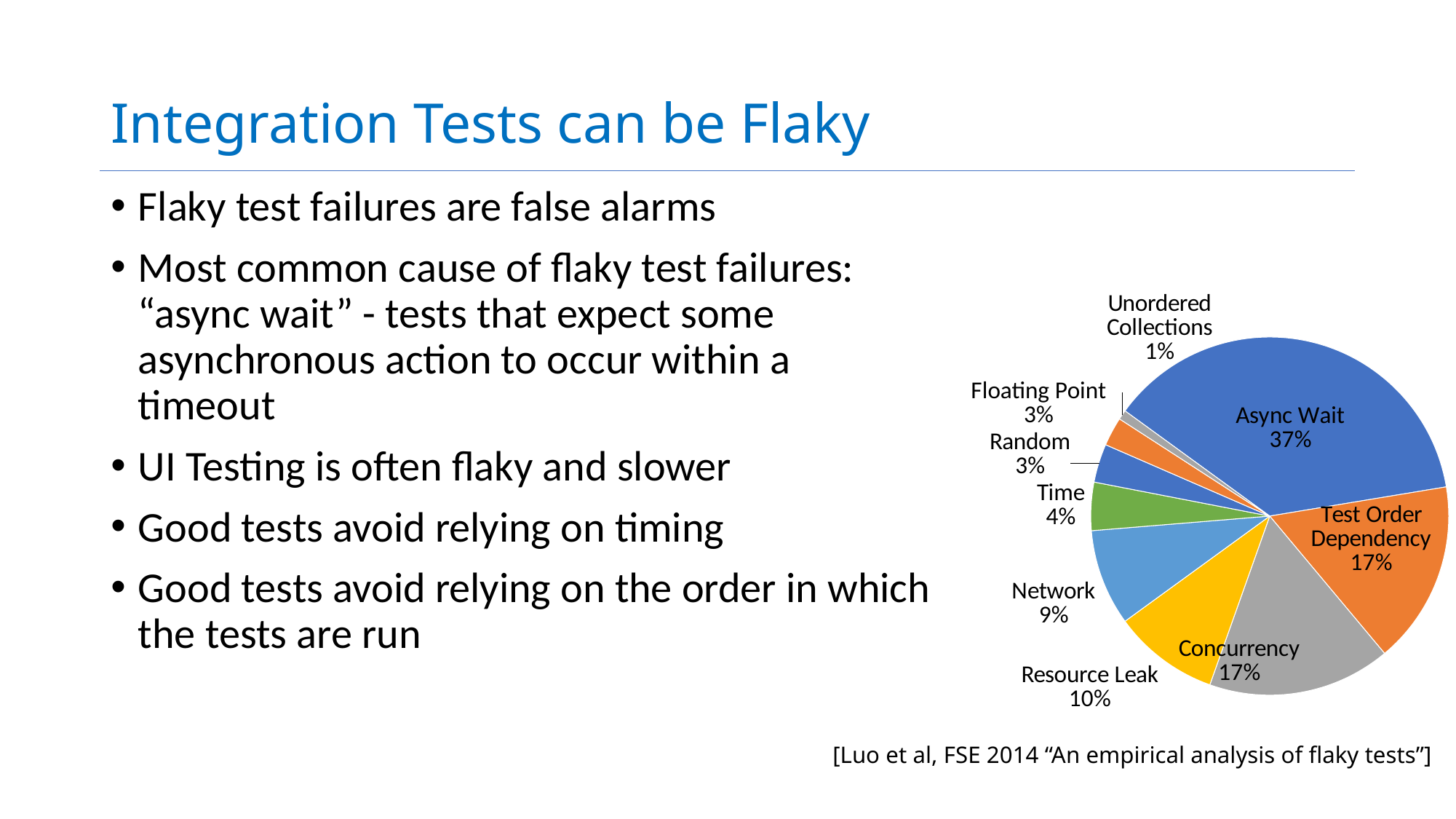
Which category has the largest slice of the pie? Async Wait How many categories are shown in the pie chart? 9 What colour is the Concurrency slice? yellow What share of the pie does Async Wait account for? 37% What is the difference between the Async Wait share and the Concurrency share? 20% What kind of chart is shown on the slide? pie chart Which is larger, the Resource Leak slice or the Network slice? Resource Leak Which category has the smallest slice of the pie? Unordered Collections What is the value shown for Time? 4% What is the value shown for Network? 9% What is the value shown for Resource Leak? 10% What is the combined share of Test Order Dependency and Concurrency? 34%